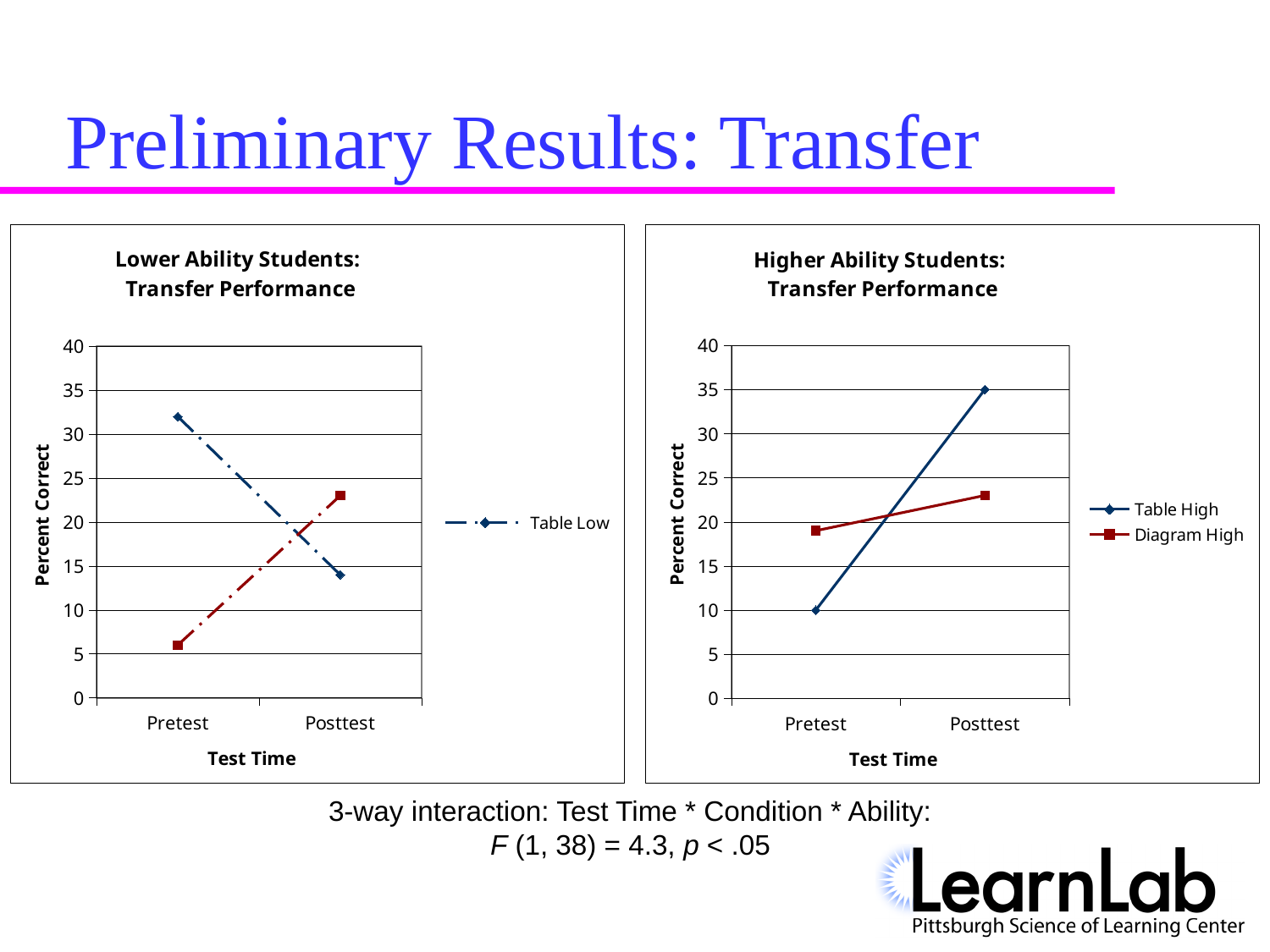
In the 'Higher Ability Students: Transfer Performance' chart, which series has the higher value at Posttest, Table High or Diagram High? Table High In the 'Higher Ability Students: Transfer Performance' chart, what is the Percent Correct for Table High at Pretest? 10 In the 'Higher Ability Students: Transfer Performance' chart, is the value for Diagram High at Posttest greater or less than 20? greater How many series does the legend of the 'Higher Ability Students: Transfer Performance' chart list? 2 In the 'Lower Ability Students: Transfer Performance' chart, does the Table Low series rise or fall from Pretest to Posttest? fall What kind of chart is the 'Lower Ability Students: Transfer Performance' chart? line chart In the 'Higher Ability Students: Transfer Performance' chart, which series has the higher value at Pretest, Table High or Diagram High? Diagram High In the 'Higher Ability Students: Transfer Performance' chart, does the Table High series rise or fall from Pretest to Posttest? rise In the 'Higher Ability Students: Transfer Performance' chart, what is the Percent Correct for Table High at Posttest? 35 In the 'Lower Ability Students: Transfer Performance' chart, is the value for Table Low at Pretest greater or less than 30? greater